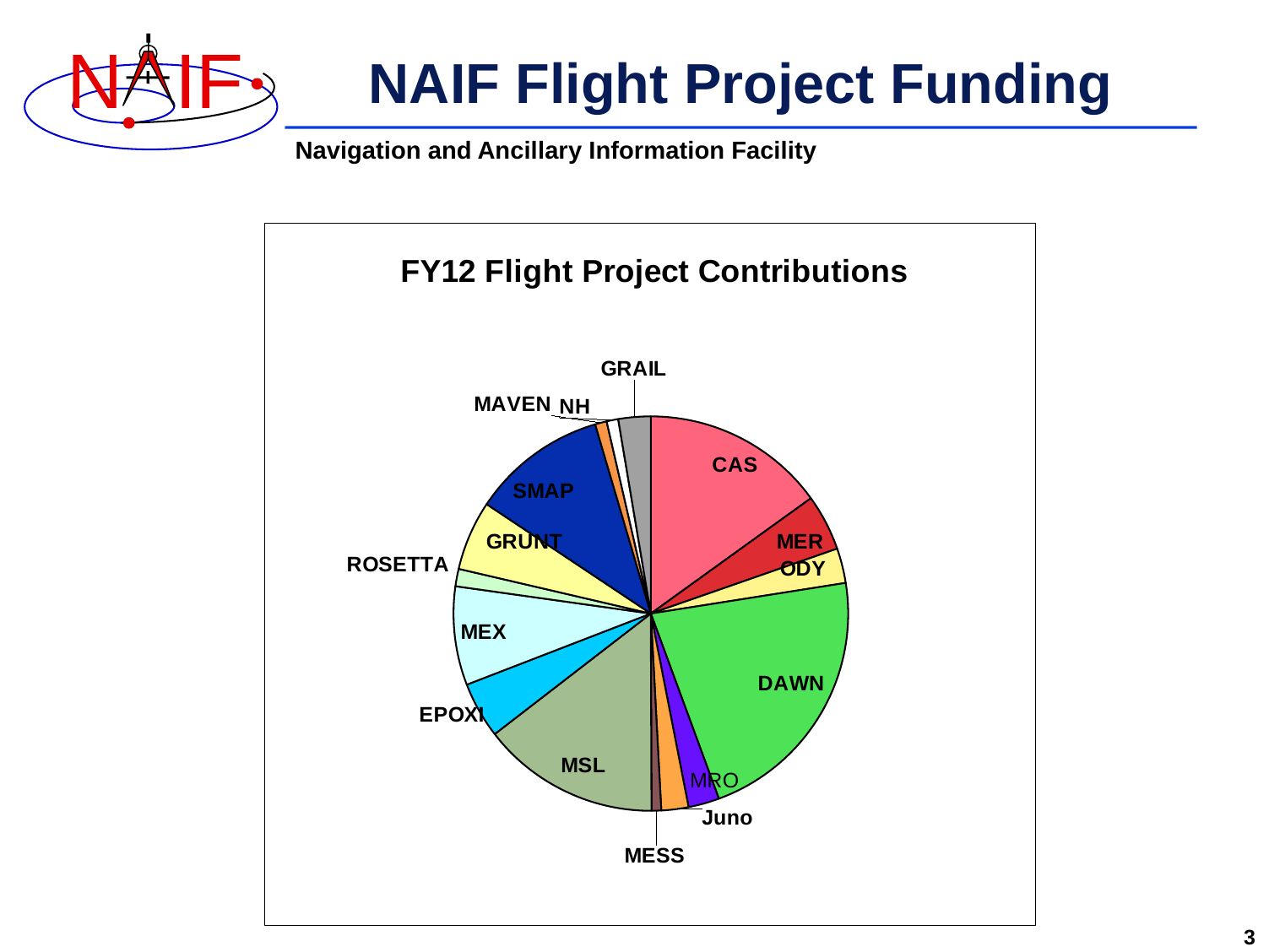
Which slice is larger, CAS or GRAIL? CAS What kind of chart is shown on the slide? pie chart How many slices does the pie chart have? 16 Which slice is larger, MEX or ROSETTA? MEX Which slice is larger, DAWN or MEX? DAWN What colour is the DAWN slice? green Which project has the largest slice of the pie? DAWN What is the title of the chart? FY12 Flight Project Contributions